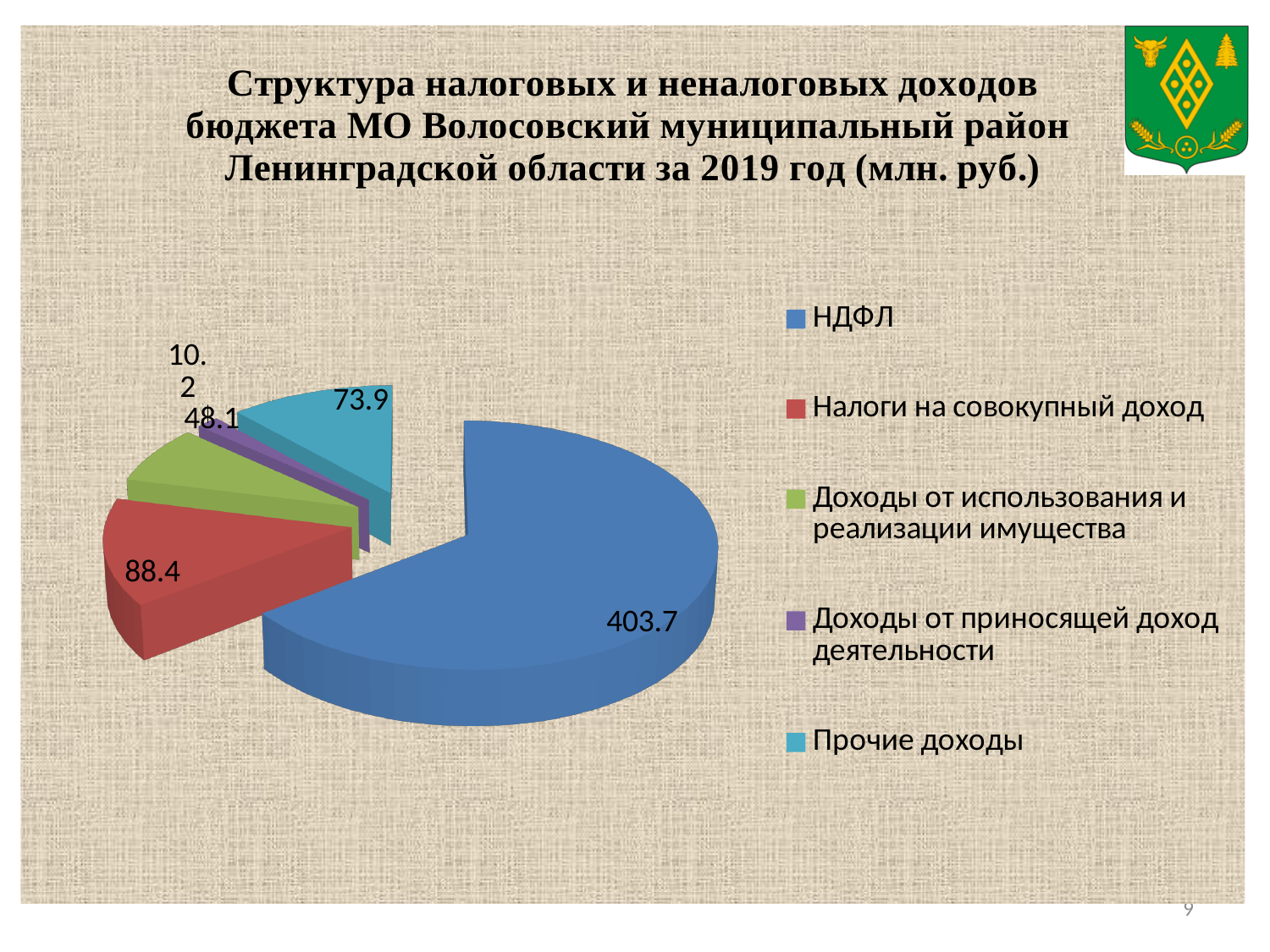
What is the value for Прочие доходы? 73.9 What type of chart is shown on the slide? pie chart Which colour represents Прочие доходы in the legend? light blue What is the value for НДФЛ? 403.7 What is the difference between the values for НДФЛ and Налоги на совокупный доход? 315.3 Which is larger: Налоги на совокупный доход or Прочие доходы? Налоги на совокупный доход What is the value for Доходы от использования и реализации имущества? 48.1 What is the value for Доходы от приносящей доход деятельности? 10.2 Which category has the largest slice? НДФЛ What is the value for Налоги на совокупный доход? 88.4 Which category has the smallest slice? Доходы от приносящей доход деятельности How many categories does the pie chart show? 5